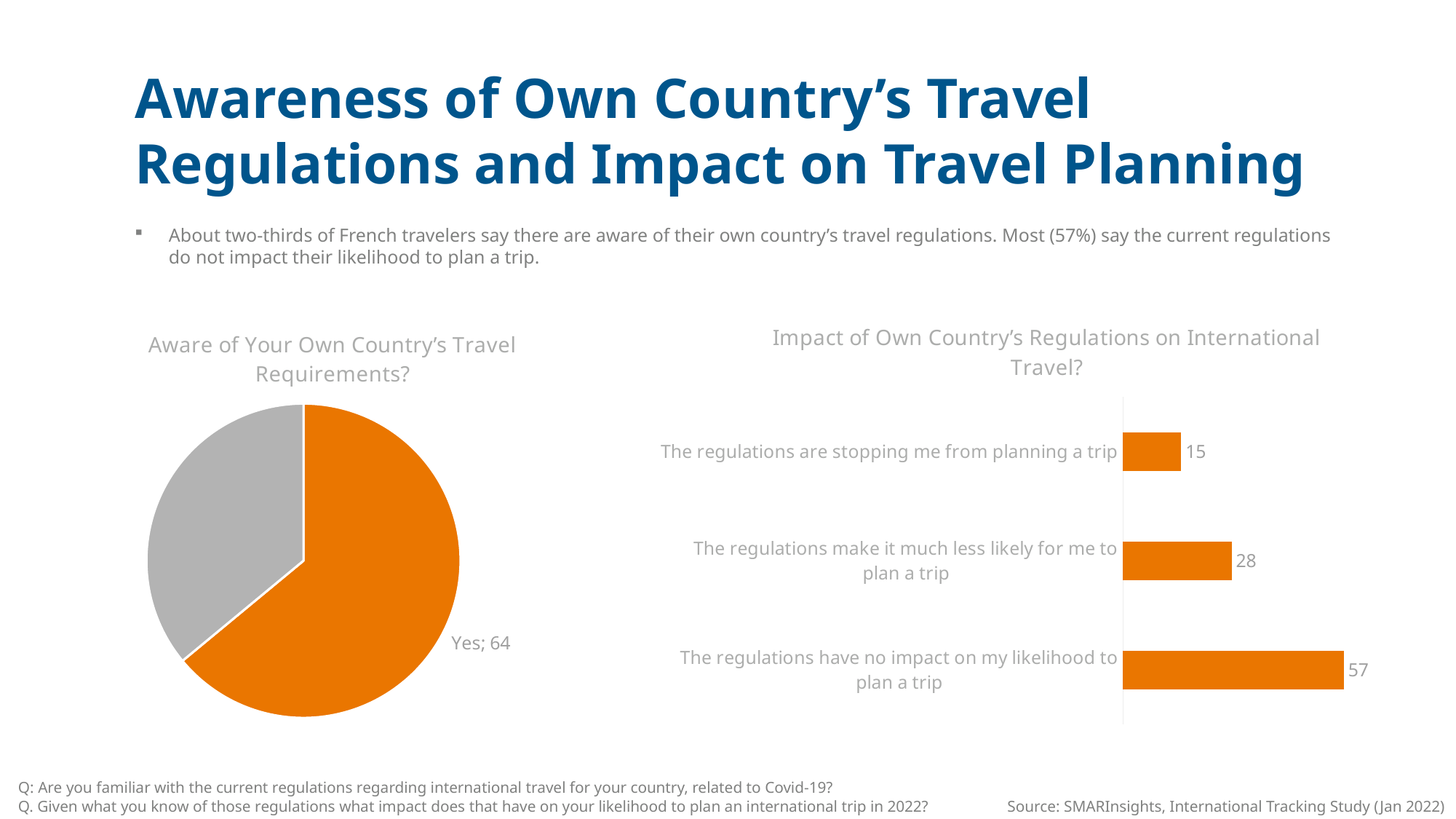
What kind of chart is 'Impact of Own Country's Regulations on International Travel?'? Bar chart In the chart 'Impact of Own Country's Regulations on International Travel?', what is the difference between 'The regulations have no impact on my likelihood to plan a trip' and 'The regulations make it much less likely for me to plan a trip'? 29 In the chart 'Impact of Own Country's Regulations on International Travel?', what is the value for 'The regulations have no impact on my likelihood to plan a trip'? 57 In the chart 'Impact of Own Country's Regulations on International Travel?', which category has the highest value? The regulations have no impact on my likelihood to plan a trip What kind of chart is the chart on the left of the slide? Pie chart In the chart 'Impact of Own Country's Regulations on International Travel?', what is the value for 'The regulations make it much less likely for me to plan a trip'? 28 In the chart 'Impact of Own Country's Regulations on International Travel?', what is the difference between 'The regulations make it much less likely for me to plan a trip' and 'The regulations are stopping me from planning a trip'? 13 In the pie chart 'Aware of Your Own Country's Travel Requirements?', what value is shown for the 'Yes' slice? 64 In the chart 'Impact of Own Country's Regulations on International Travel?', which category has the lowest value? The regulations are stopping me from planning a trip How many categories are shown in the chart 'Impact of Own Country's Regulations on International Travel?'? 3 In the chart 'Impact of Own Country's Regulations on International Travel?', which is larger: 'The regulations are stopping me from planning a trip' or 'The regulations make it much less likely for me to plan a trip'? The regulations make it much less likely for me to plan a trip In the chart 'Impact of Own Country's Regulations on International Travel?', what is the value for 'The regulations are stopping me from planning a trip'? 15